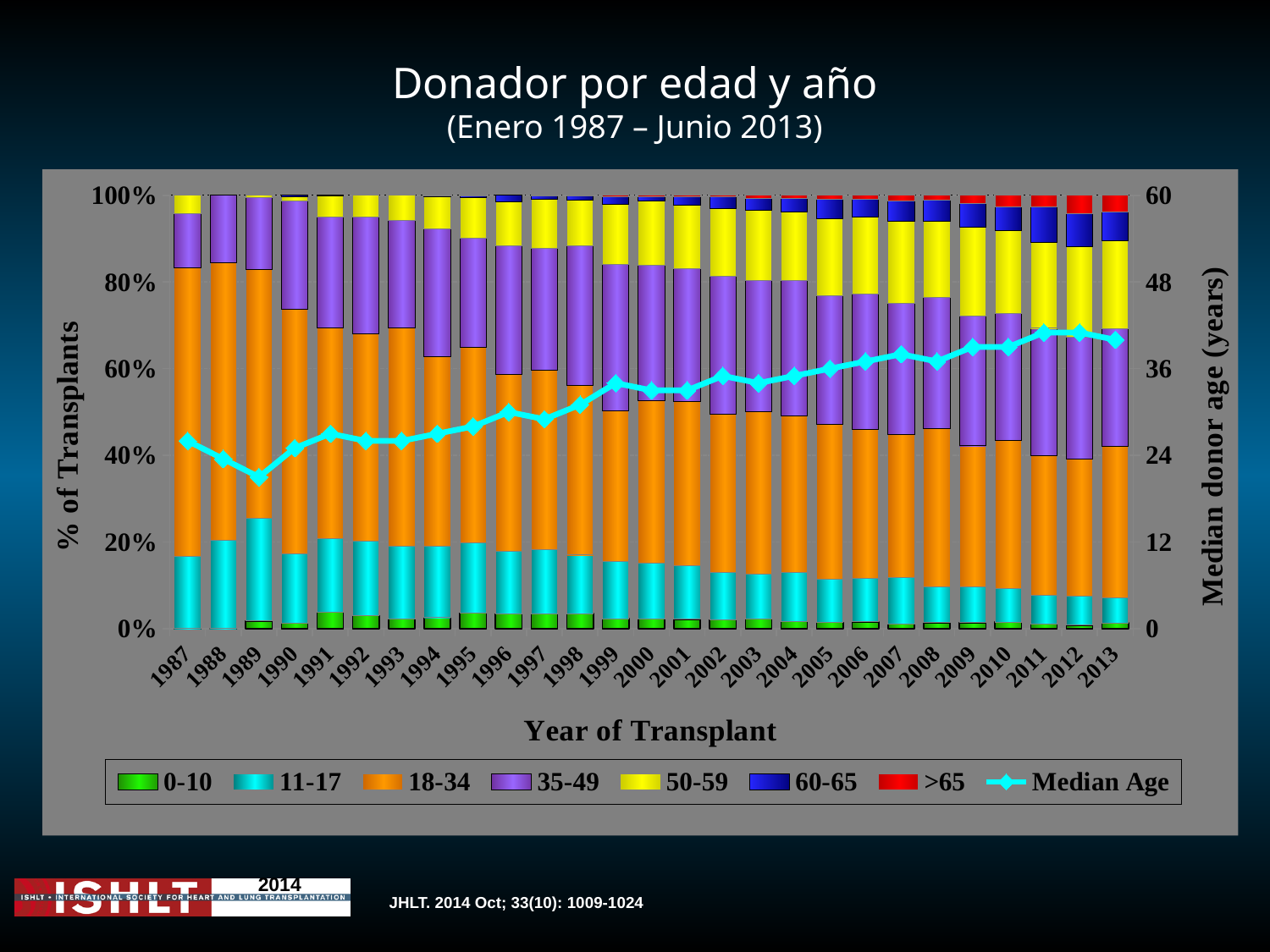
Is the share of donors aged 11-17 in 1987 greater or less than 20%? less What is the label of the right y axis? Median donor age (years) Which year has the larger share of donors aged 18-34, 1987 or 2013? 1987 Which year has the higher Median Age, 1987 or 2013? 2013 Is the Median Age value for 2011 greater or less than 36? greater How many entries does the chart legend list? 8 How many years are shown along the x axis of the chart? 27 In which year is the Median Age line at its lowest? 1989 What kind of chart is shown on the slide? Stacked bar chart with a line What is the label of the left y axis? % of Transplants Is the Median Age value for 1989 greater or less than 24? less Does the Median Age line generally rise or fall from 1987 to 2013? rise